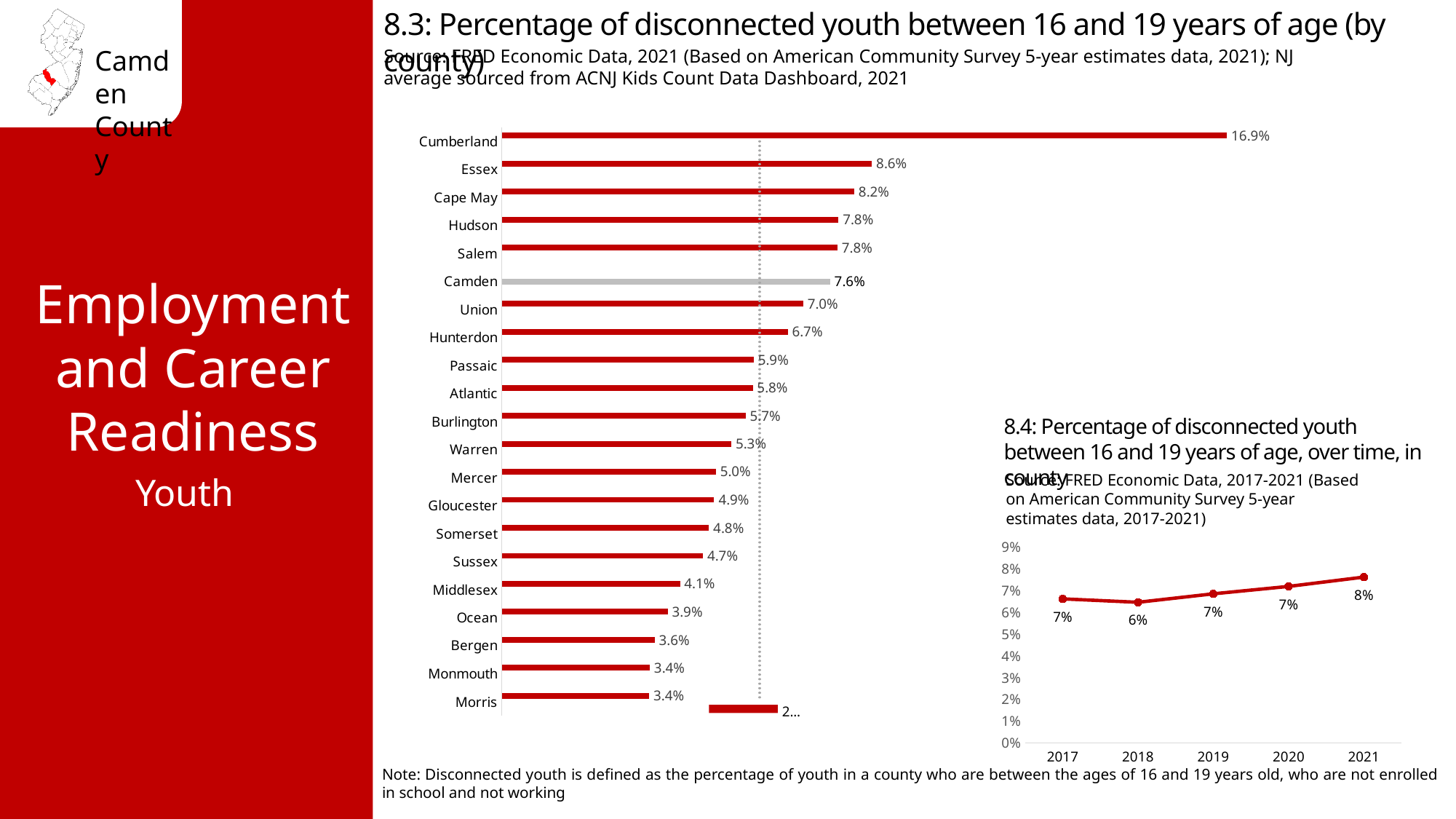
In chart 8.3 (percentage of disconnected youth by county), what is the value for Bergen? 3.6% In chart 8.4 (percentage of disconnected youth over time), what is the value for 2021? 8% In chart 8.3 (percentage of disconnected youth by county), which county has the highest value? Cumberland In chart 8.3 (percentage of disconnected youth by county), what is the difference between Cumberland and Essex? 8.3% In chart 8.3 (percentage of disconnected youth by county), what is the value for Essex? 8.6% In chart 8.3 (percentage of disconnected youth by county), how many counties are shown? 21 In chart 8.4 (percentage of disconnected youth over time), how many years are plotted? 5 In chart 8.3 (percentage of disconnected youth by county), which is larger, the value for Cape May or the value for Union? Cape May What kind of chart is chart 8.3 (percentage of disconnected youth by county)? Bar chart In chart 8.4 (percentage of disconnected youth over time), which year has the lowest value? 2018 What kind of chart is chart 8.4 (percentage of disconnected youth over time)? Line chart In chart 8.3 (percentage of disconnected youth by county), what is the value for Camden? 7.6%